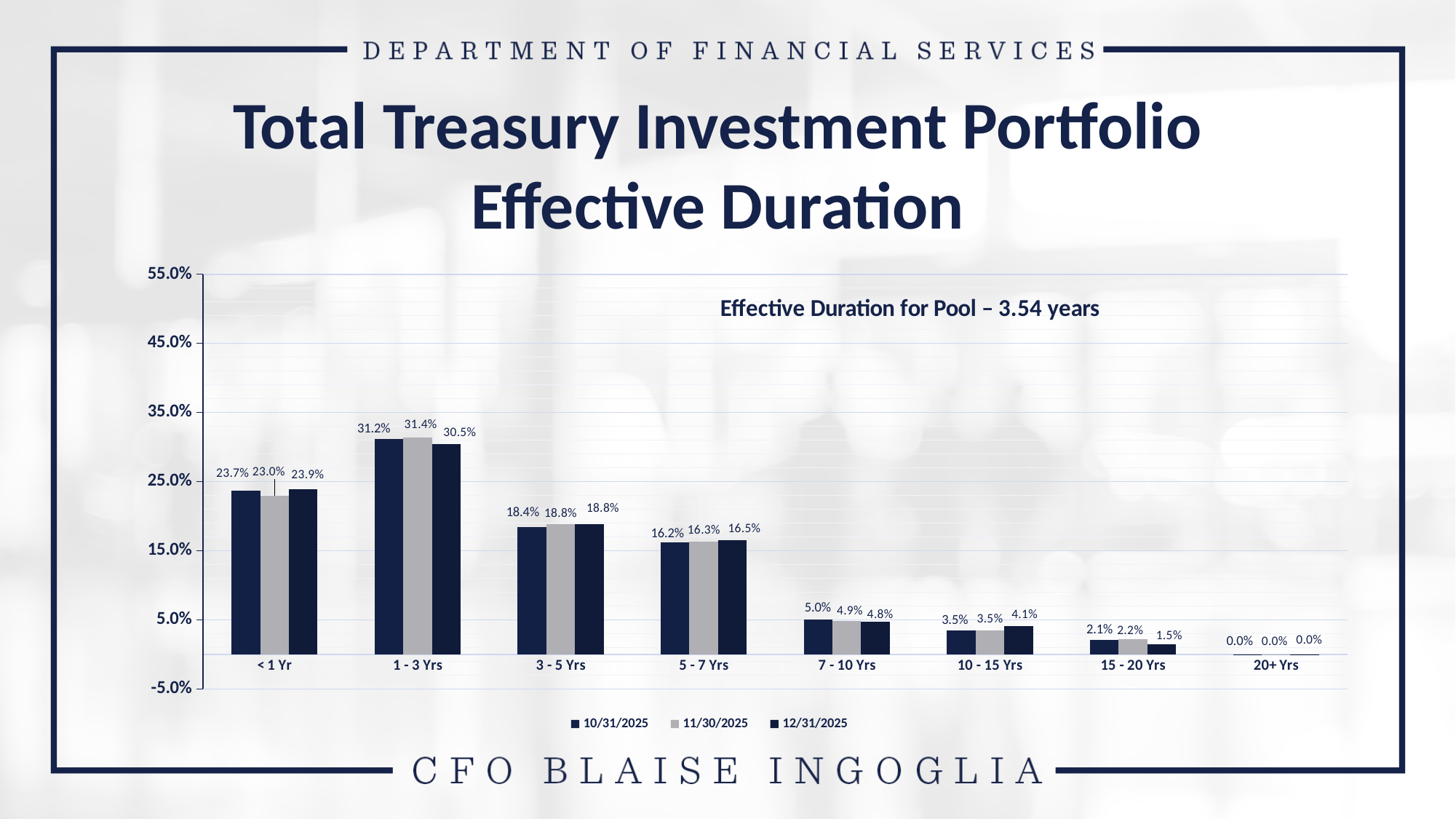
Which is larger for the 10 - 15 Yrs category: the 11/30/2025 value or the 12/31/2025 value? 12/31/2025 Is the 11/30/2025 value for the 3 - 5 Yrs category greater or less than 15.0%? greater Which category has the lowest value in the 10/31/2025 series? 20+ Yrs What is the value for the < 1 Yr category in the 12/31/2025 series? 23.9% What is the value for the 7 - 10 Yrs category in the 10/31/2025 series? 5.0% How many maturity categories are shown on the x axis? 8 What is the difference between the 10/31/2025 and 12/31/2025 values for the 1 - 3 Yrs category? 0.7% What effective duration for the pool is stated on the chart? 3.54 years What is the value for the 1 - 3 Yrs category in the 11/30/2025 series? 31.4% How many series does the legend list? 3 What kind of chart is shown on the slide? Bar chart Which category has the highest value in the 12/31/2025 series? 1 - 3 Yrs